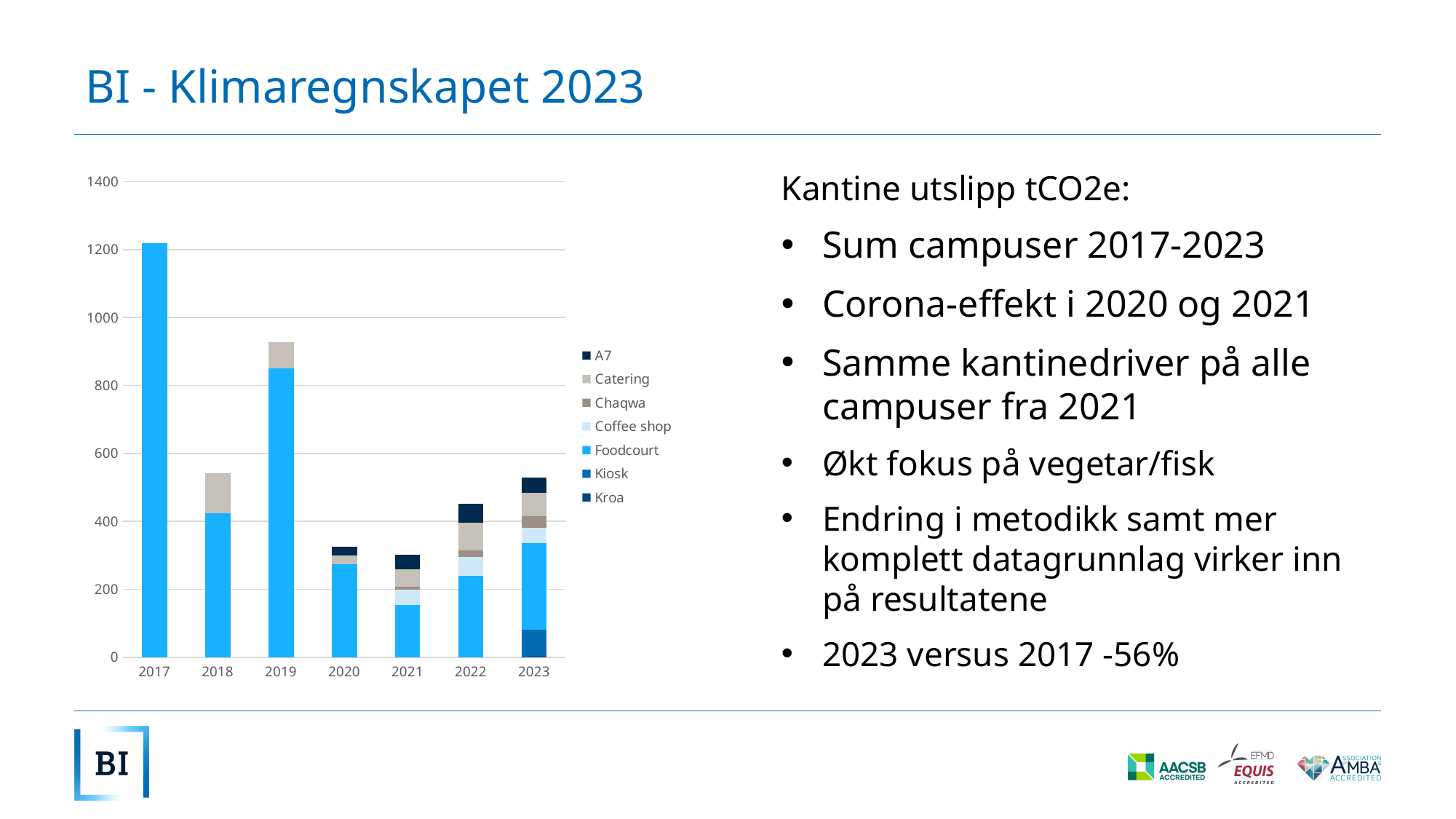
Do the total bars rise or fall from 2021 to 2023? rise Which year has the highest total bar in the chart? 2017 Which series in the legend is shown in light blue and makes up the largest part of each bar? Foodcourt What kind of chart is shown on the slide? Stacked bar chart Is the total for 2019 greater or less than 800? greater How many series does the chart legend list? 7 Is the total for 2022 greater or less than 400? greater Is the total for 2017 greater or less than 1000? greater How many years are shown on the x axis of the chart? 7 Which year has the larger total bar, 2018 or 2019? 2019